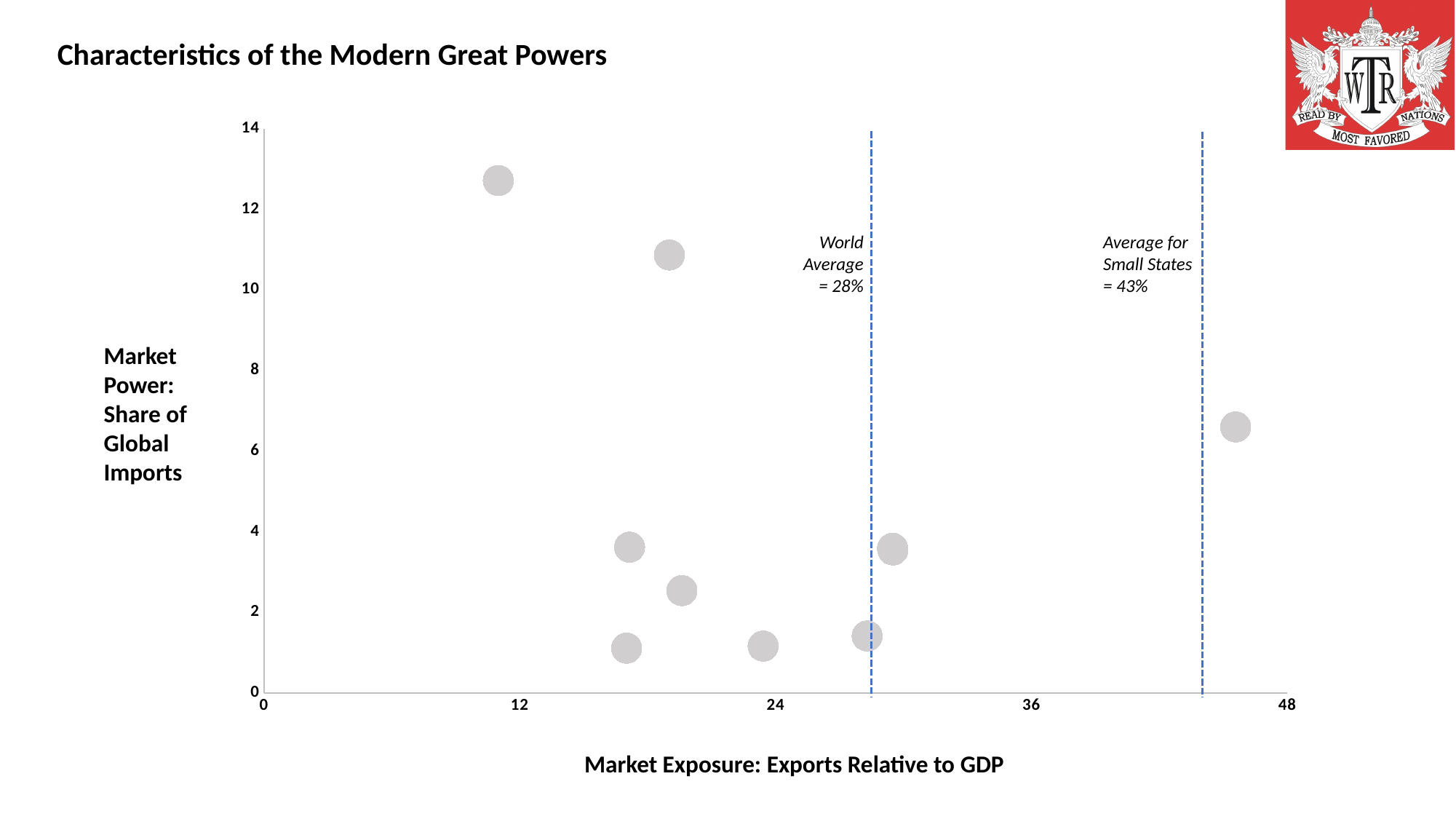
What is the title of the x axis? Market Exposure: Exports Relative to GDP Which is larger, the World Average or the Average for Small States? Average for Small States What is the difference between the Average for Small States and the World Average? 15% Is the exports-relative-to-GDP value for the rightmost point greater or less than 36? greater What kind of chart is shown on the slide? scatter plot How many points lie to the right of the Average for Small States line? 1 What value is given for the Average for Small States reference line? 43% What value is given for the World Average reference line? 28% What is the highest tick value shown on the y axis? 14 What is the title of the y axis? Market Power: Share of Global Imports Is the share of global imports for the highest point on the chart greater or less than 12? greater